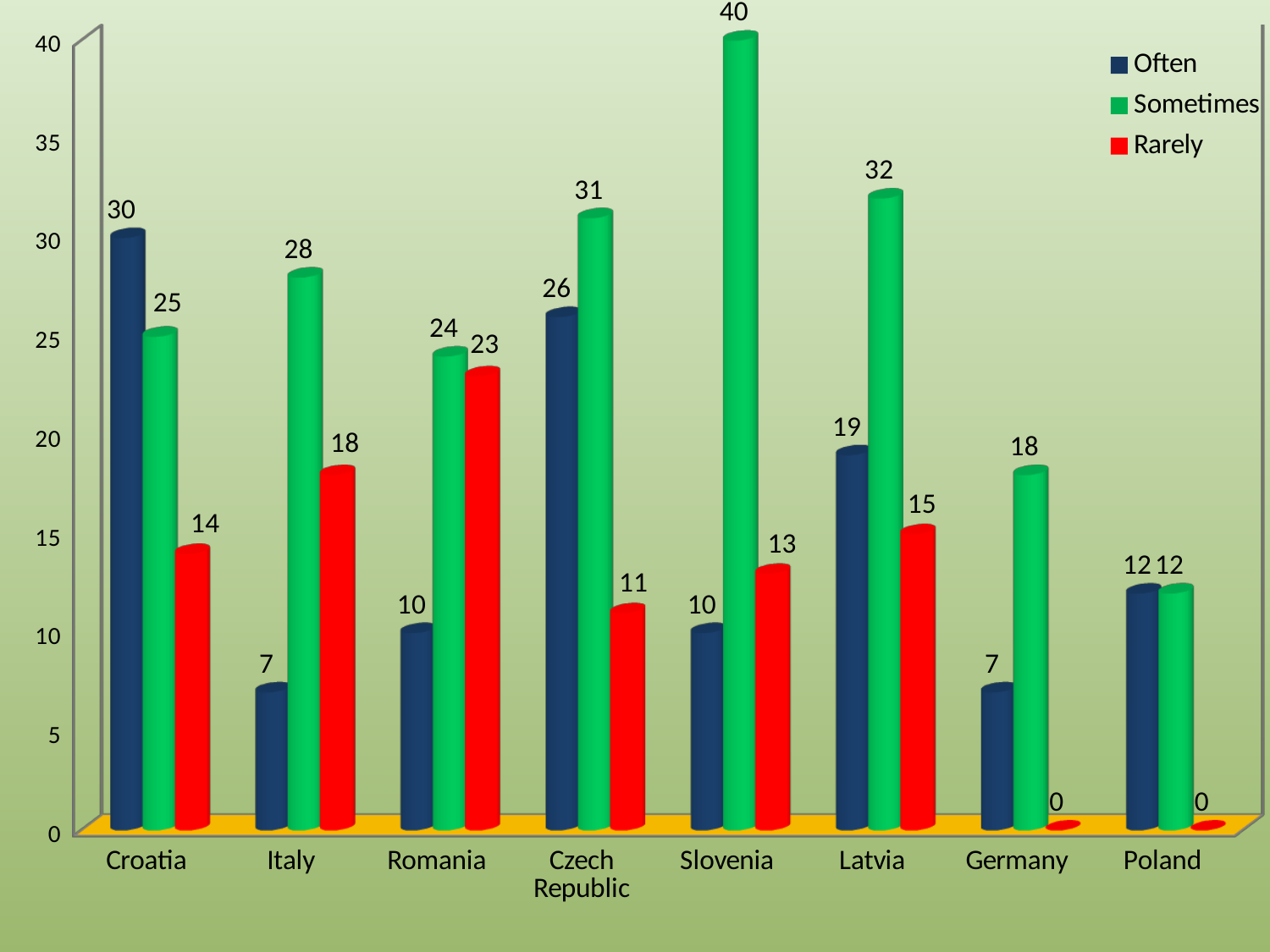
Which colour represents the Rarely series? red How many countries are shown on the x axis? 8 What is the value for Rarely in Romania? 23 What is the total of the three values for Poland? 24 What kind of chart is this? bar chart How many series does the legend list? 3 What is the difference between the Sometimes and Rarely values for Latvia? 17 What is the value for Often in Croatia? 30 Which country has the highest value for Sometimes? Slovenia Which is larger in the Czech Republic, the Often value or the Sometimes value? Sometimes Which country has the lowest value for Often? Italy and Germany What is the value for Sometimes in Slovenia? 40